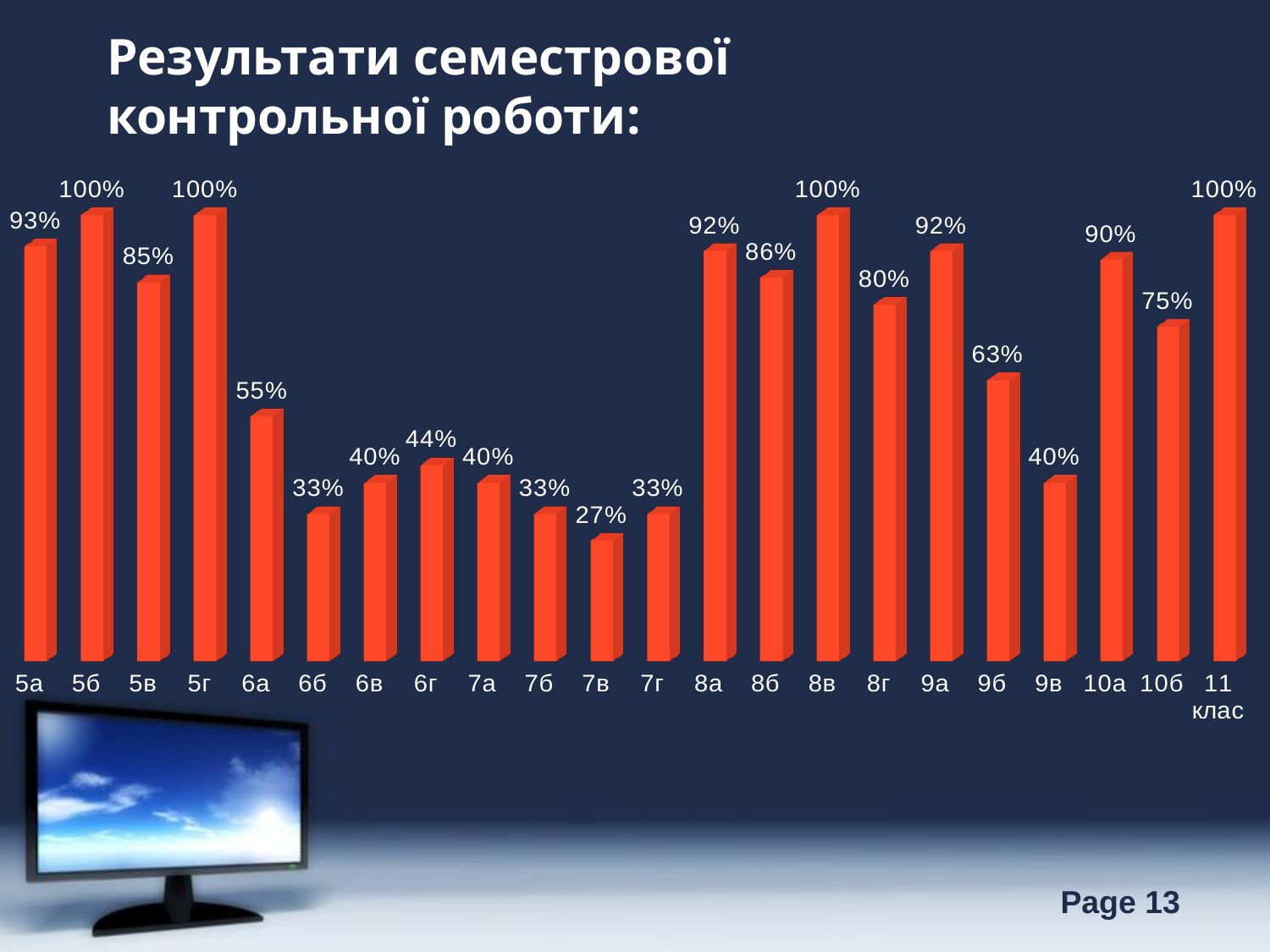
What is the value for 5в? 85% Which is larger, the value for 8б or the value for 9а? 9а What is the value for 9б? 63% How many categories are shown in the chart? 22 Which is larger, the value for 6г or the value for 7б? 6г Which category has the lowest value? 7в What is the value for 7в? 27% What is the difference between the values for 6а and 6б? 22% What is the title of the slide? Результати семестрової контрольної роботи: What is the value for 10б? 75% What kind of chart is shown on the slide? Bar chart What is the difference between the values for 8в and 8г? 20%